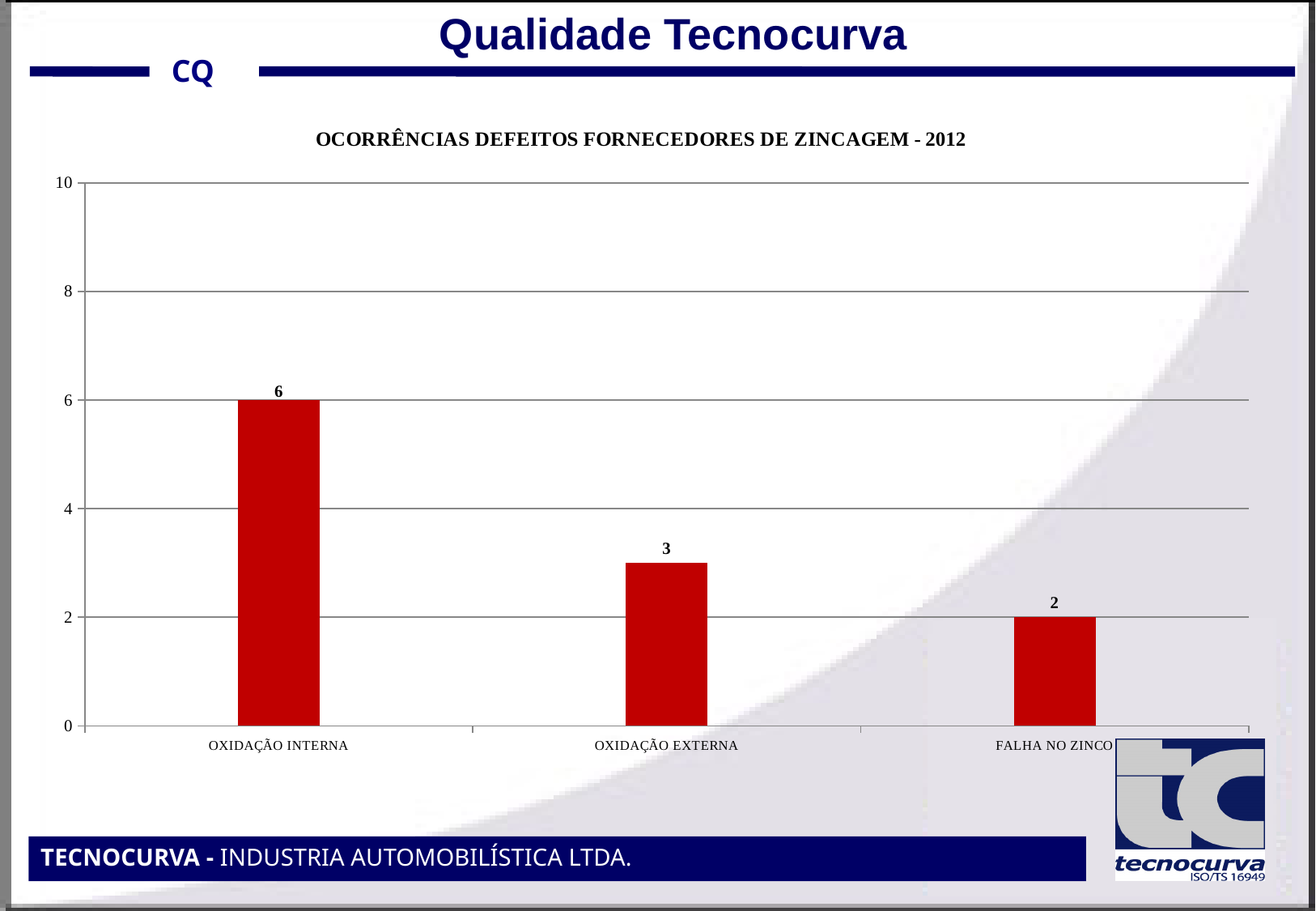
Is the value for OXIDAÇÃO INTERNA greater or less than 4? greater What is the title of the chart? OCORRÊNCIAS DEFEITOS FORNECEDORES DE ZINCAGEM - 2012 What kind of chart is shown on the slide? bar chart What is the value for OXIDAÇÃO INTERNA? 6 What is the difference between the values for OXIDAÇÃO INTERNA and OXIDAÇÃO EXTERNA? 3 How many categories are shown on the chart? 3 What is the difference between the values for OXIDAÇÃO EXTERNA and FALHA NO ZINCO? 1 What is the value for FALHA NO ZINCO? 2 What is the value for OXIDAÇÃO EXTERNA? 3 Which category has the highest value? OXIDAÇÃO INTERNA Which is larger, the value for OXIDAÇÃO EXTERNA or the value for FALHA NO ZINCO? OXIDAÇÃO EXTERNA Which category has the lowest value? FALHA NO ZINCO